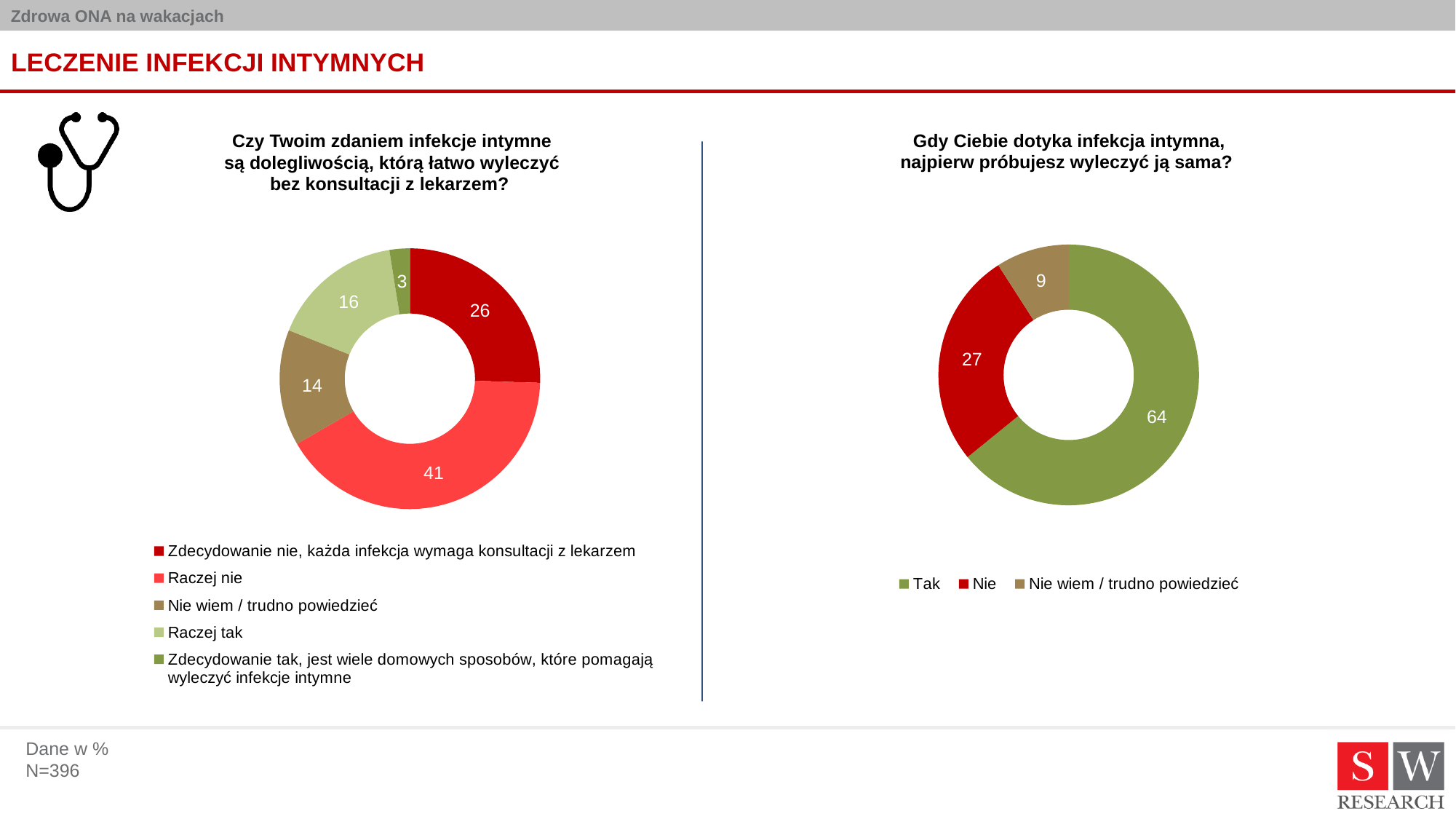
In the left chart, what is the value for "Raczej nie"? 41 What type of chart is the right chart? Donut (pie) chart How many categories does the legend of the left chart list? 5 In the left chart, what is the value for "Zdecydowanie nie, każda infekcja wymaga konsultacji z lekarzem"? 26 In the left chart, what is the difference between "Raczej nie" and "Nie wiem / trudno powiedzieć"? 27 In the right chart, what is the value for "Tak"? 64 In the left chart, which category has the smallest value? Zdecydowanie tak, jest wiele domowych sposobów, które pomagają wyleczyć infekcje intymne In the right chart, what is the value for "Nie wiem / trudno powiedzieć"? 9 In the right chart, which is larger, "Tak" or "Nie"? Tak In the right chart, what is the difference between "Tak" and "Nie"? 37 In the left chart, which category has the largest value? Raczej nie In the left chart, what is the value for "Raczej tak"? 16